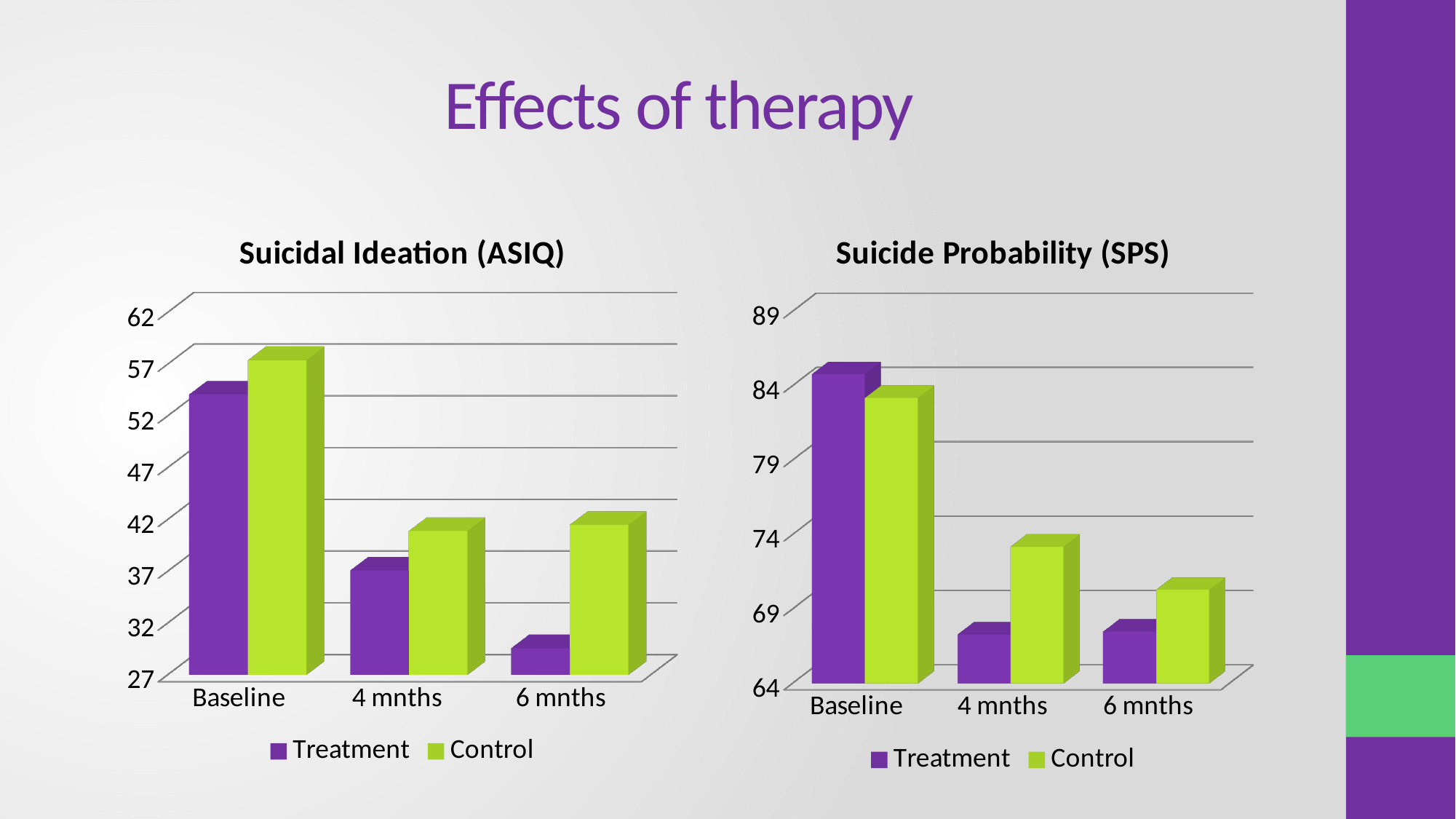
In the Suicidal Ideation (ASIQ) chart, at 4 mnths, which is larger: Treatment or Control? Control In the Suicide Probability (SPS) chart, does the Treatment series rise or fall from Baseline to 6 mnths? Fall How many categories are shown on the x axis of the Suicidal Ideation (ASIQ) chart? 3 In the Suicidal Ideation (ASIQ) chart, which bar is the highest? Control at Baseline What kind of chart is the Suicidal Ideation (ASIQ) chart? Bar chart How many series does the legend of the Suicide Probability (SPS) chart list? 2 In the Suicide Probability (SPS) chart, is the Treatment value at 4 mnths greater or less than 69? less In the Suicidal Ideation (ASIQ) chart, is the Treatment value at 6 mnths greater or less than 32? less In the Suicidal Ideation (ASIQ) chart, is the Treatment value at Baseline greater or less than 47? greater What colour represents the Control series in the Suicide Probability (SPS) chart? Green In the Suicidal Ideation (ASIQ) chart, which bar is the lowest? Treatment at 6 mnths